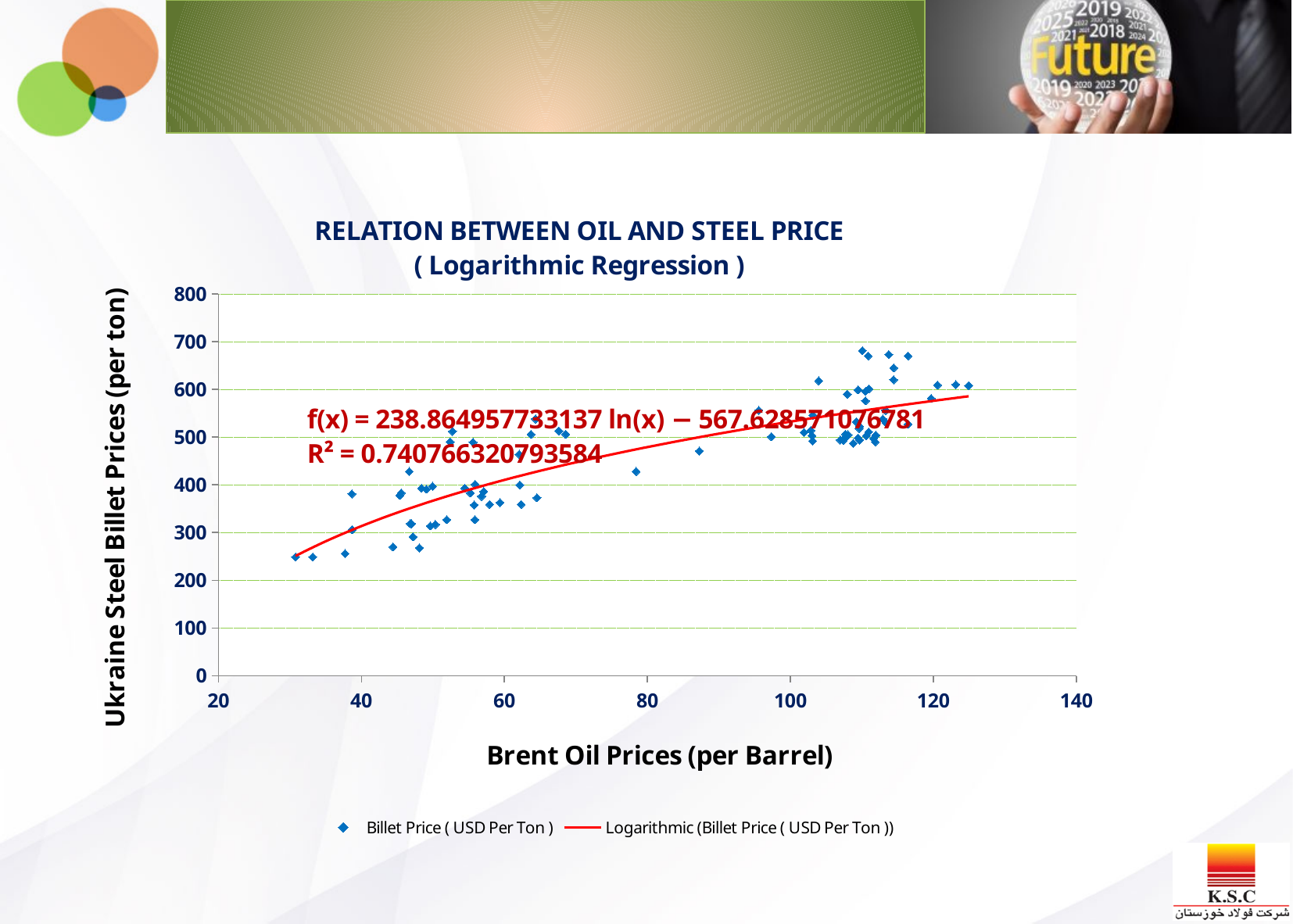
What is the title of the chart? RELATION BETWEEN OIL AND STEEL PRICE ( Logarithmic Regression ) What kind of chart is shown on the slide? scatter chart Is the lowest plotted billet price greater or less than 300? less Are the billet prices plotted at a Brent oil price of about 120 greater or less than 500? greater Do the billet prices generally rise or fall as Brent oil prices increase along the x axis? rise What is the highest tick value shown on the x axis? 140 What is the label of the x axis? Brent Oil Prices (per Barrel) What is the coefficient of ln(x) in the regression equation printed on the chart? 238.864957733137 Is the highest plotted billet price greater or less than 700? less What is the R² value printed on the chart? 0.740766320793584 How many entries does the chart legend list? 2 What is the constant term subtracted in the regression equation printed on the chart? 567.628571076781